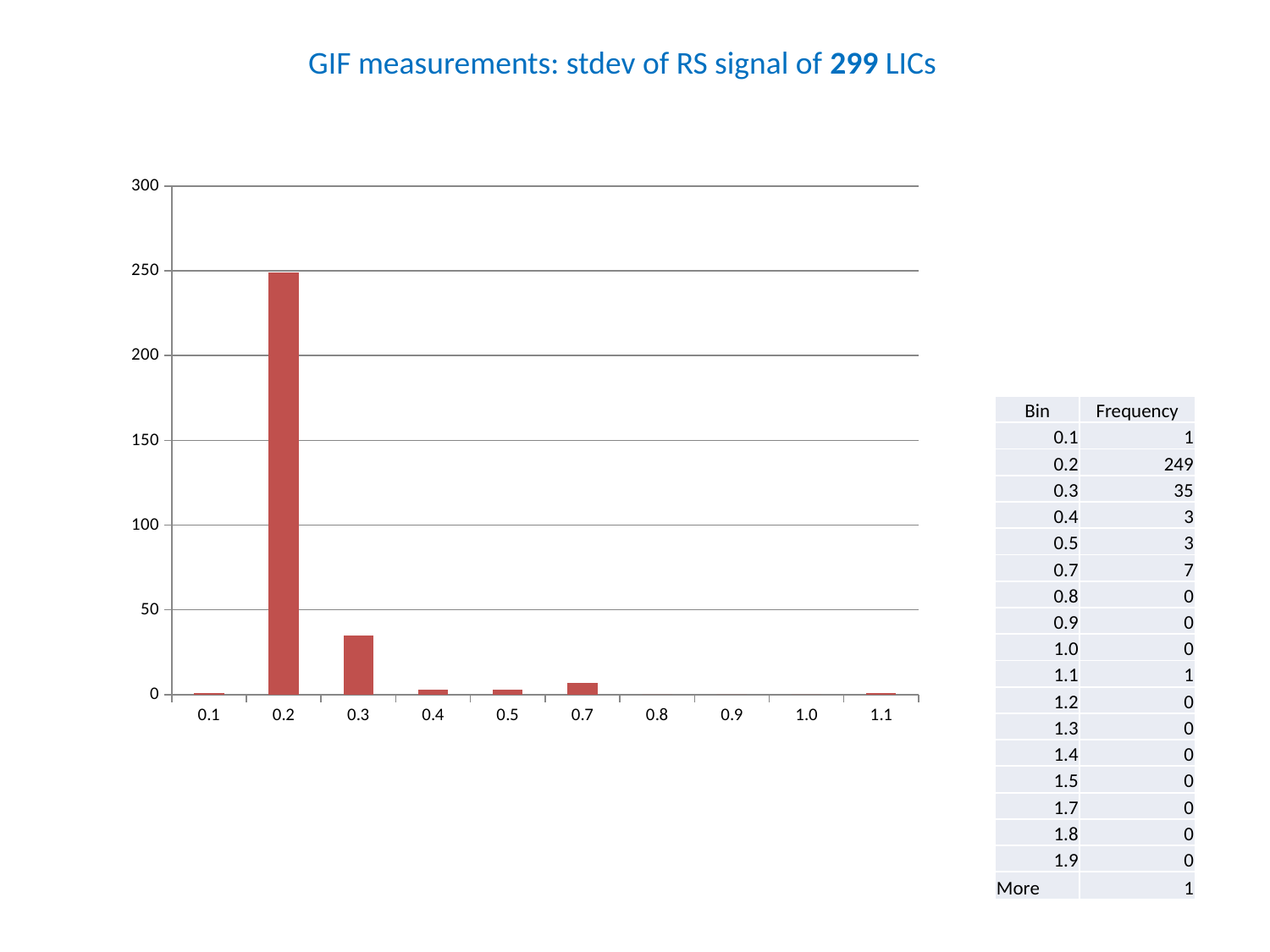
What is the frequency for bin 0.3 according to the table? 35 Which bin has the larger frequency, 0.3 or 0.7? 0.3 What is the difference between the frequencies of bin 0.2 and bin 0.3? 214 Is the value for bin 0.3 greater or less than 50? less What is the frequency for bin 0.2 according to the table? 249 Which bin has the highest frequency in the chart? 0.2 What is the title of the slide? GIF measurements: stdev of RS signal of 299 LICs Is the value for bin 0.2 greater or less than 200? greater What type of chart is shown on the slide? bar chart How many bins are shown along the x axis of the chart? 10 What is the frequency for bin 0.7 according to the table? 7 What is the frequency for bin 0.8 according to the table? 0